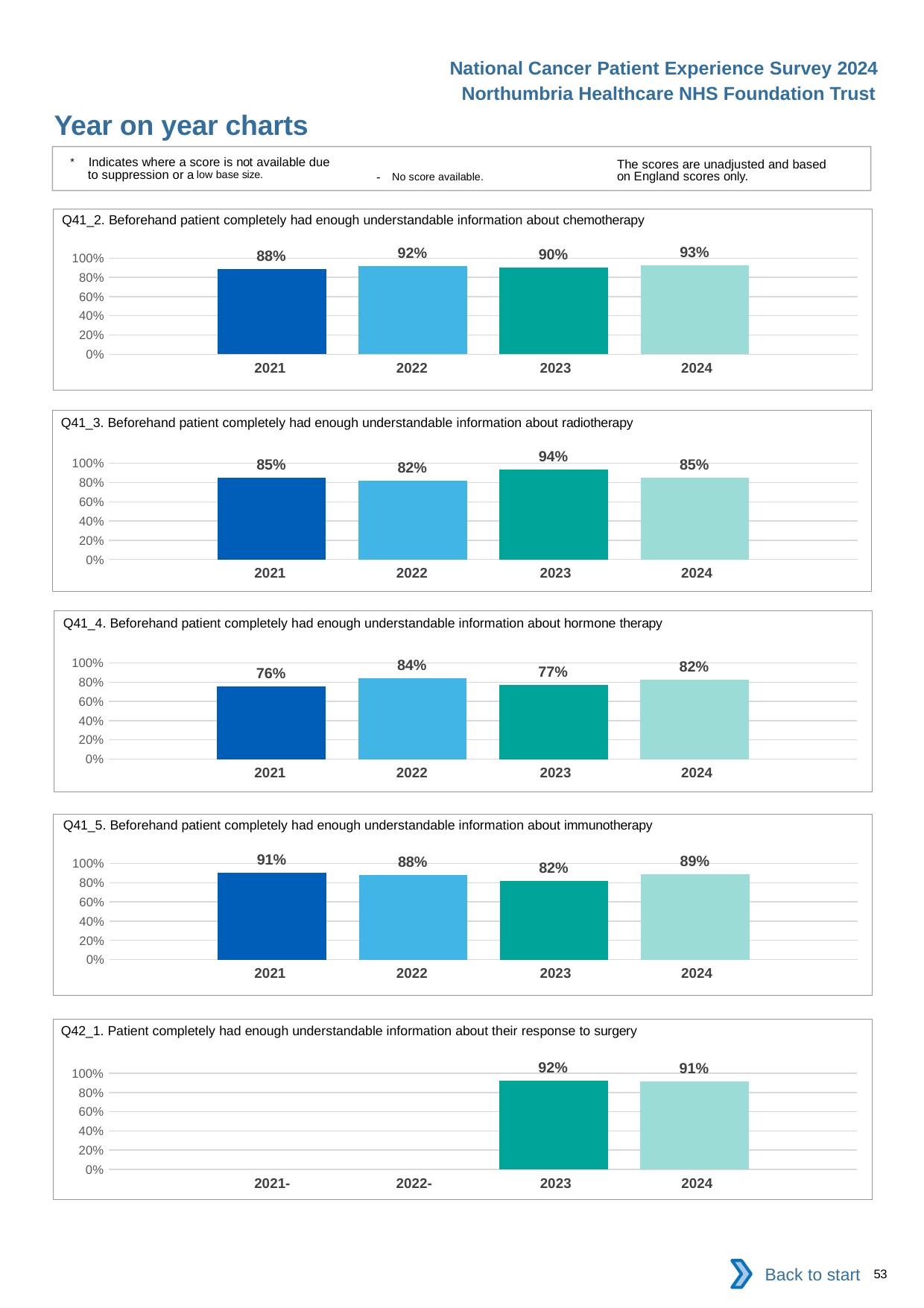
In the Q41_3 chart (radiotherapy), which year has the highest value? 2023 In the Q41_5 chart (immunotherapy), what is the difference between the 2021 and 2023 values? 9% How many charts are shown on the slide? 5 In the Q41_3 chart (radiotherapy), what is the value for 2022? 82% In the Q41_4 chart (hormone therapy), what is the difference between the 2022 and 2021 values? 8% In the Q41_4 chart (hormone therapy), which year has the lowest value? 2021 What type of chart is the Q41_2 chart (chemotherapy)? Bar chart In the Q41_2 chart (chemotherapy), which year has the lowest value? 2021 In the Q41_5 chart (immunotherapy), is the value for 2023 greater or less than 80%? greater How many bars with values are plotted in the Q42_1 chart (response to surgery)? 2 In the Q41_2 chart (chemotherapy), what is the value for 2024? 93% In the Q42_1 chart (response to surgery), which is larger, the value for 2023 or 2024? 2023